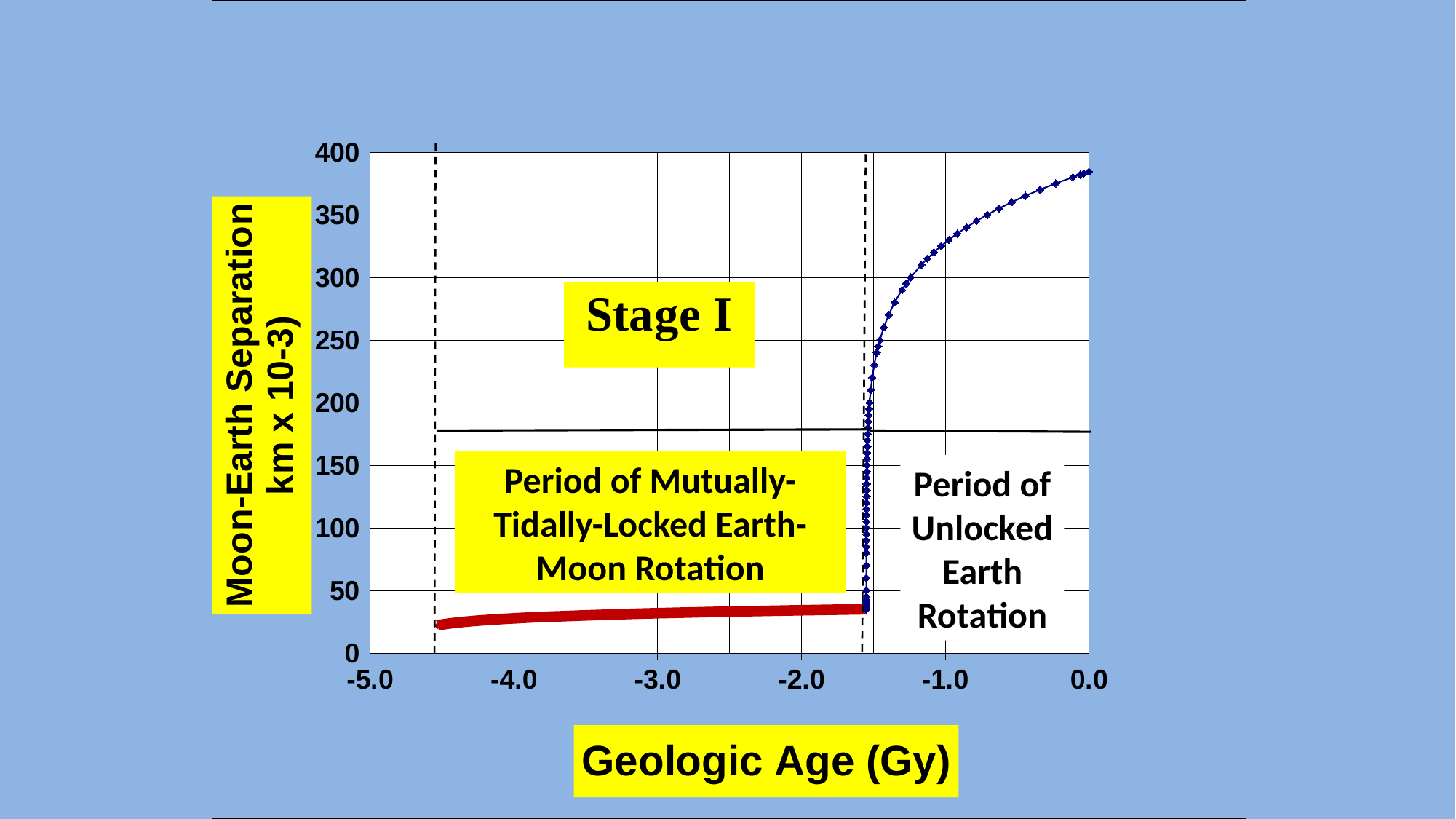
Is the Moon-Earth separation at geologic age -1.0 greater or less than 250? greater How many labelled tick marks are on the x axis? 6 What is the title of the x axis? Geologic Age (Gy) Is the Moon-Earth separation at geologic age -2.0 greater or less than 100? less What is the highest value labelled on the y axis? 400 Is the Moon-Earth separation at geologic age -4.0 greater or less than 50? less Does the Moon-Earth separation rise or fall as geologic age moves from -5.0 toward 0.0? rise Which has the larger Moon-Earth separation: geologic age -3.0 or geologic age -1.0? -1.0 What kind of chart is shown on the slide? line chart What label is shown in the region to the right of the second dashed vertical line? Period of Unlocked Earth Rotation